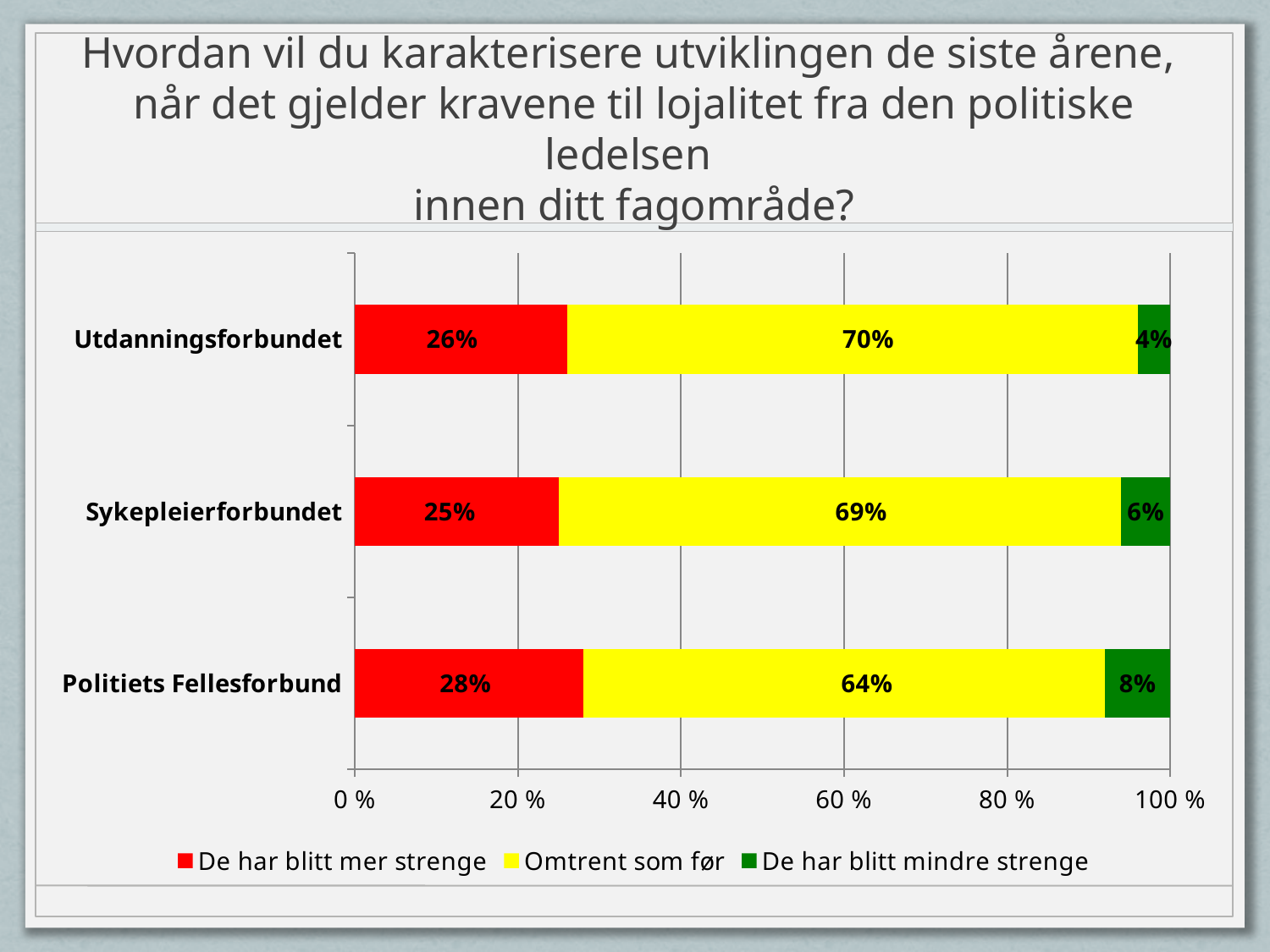
What is the total of the stacked bar for Sykepleierforbundet? 100% Which category has the lowest value for "Omtrent som før"? Politiets Fellesforbund What kind of chart is shown on the slide? Stacked bar chart Which colour represents "Omtrent som før" in the legend? Yellow How many categories are shown on the chart? 3 What is the value for "De har blitt mindre strenge" for Sykepleierforbundet? 6% Which category has the highest value for "De har blitt mindre strenge"? Politiets Fellesforbund Which is larger: the "De har blitt mer strenge" value for Politiets Fellesforbund or for Sykepleierforbundet? Politiets Fellesforbund What is the difference between the "Omtrent som før" values for Utdanningsforbundet and Politiets Fellesforbund? 6% How many series does the legend list? 3 What is the value for "Omtrent som før" for Utdanningsforbundet? 70% What is the value for "De har blitt mer strenge" for Politiets Fellesforbund? 28%